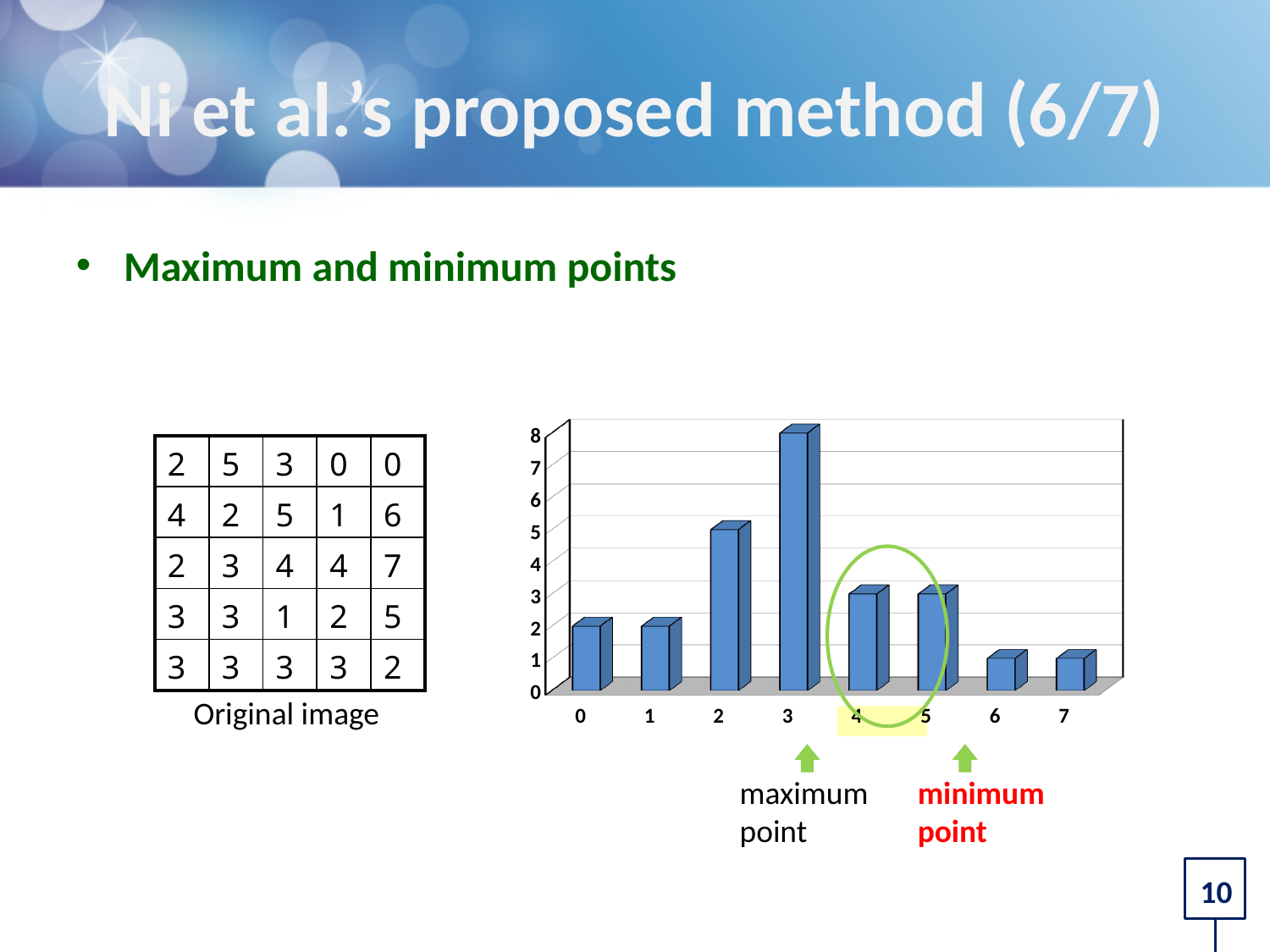
What is the value of the bar for category 4? 3 What is the value of the bar for category 3? 8 What kind of chart is shown on the slide? bar chart Which category has the highest bar in the chart? 3 Is the value for category 6 greater or less than 2? less What is the difference between the bar for category 3 and the bar for category 2? 3 Which category is labelled as the minimum point below the chart? 5 What is the value of the bar for category 2? 5 What is the value of the bar for category 0? 2 How many categories are shown on the x axis of the bar chart? 8 Is the value for category 3 greater or less than 6? greater Which is larger, the bar for category 2 or the bar for category 4? category 2